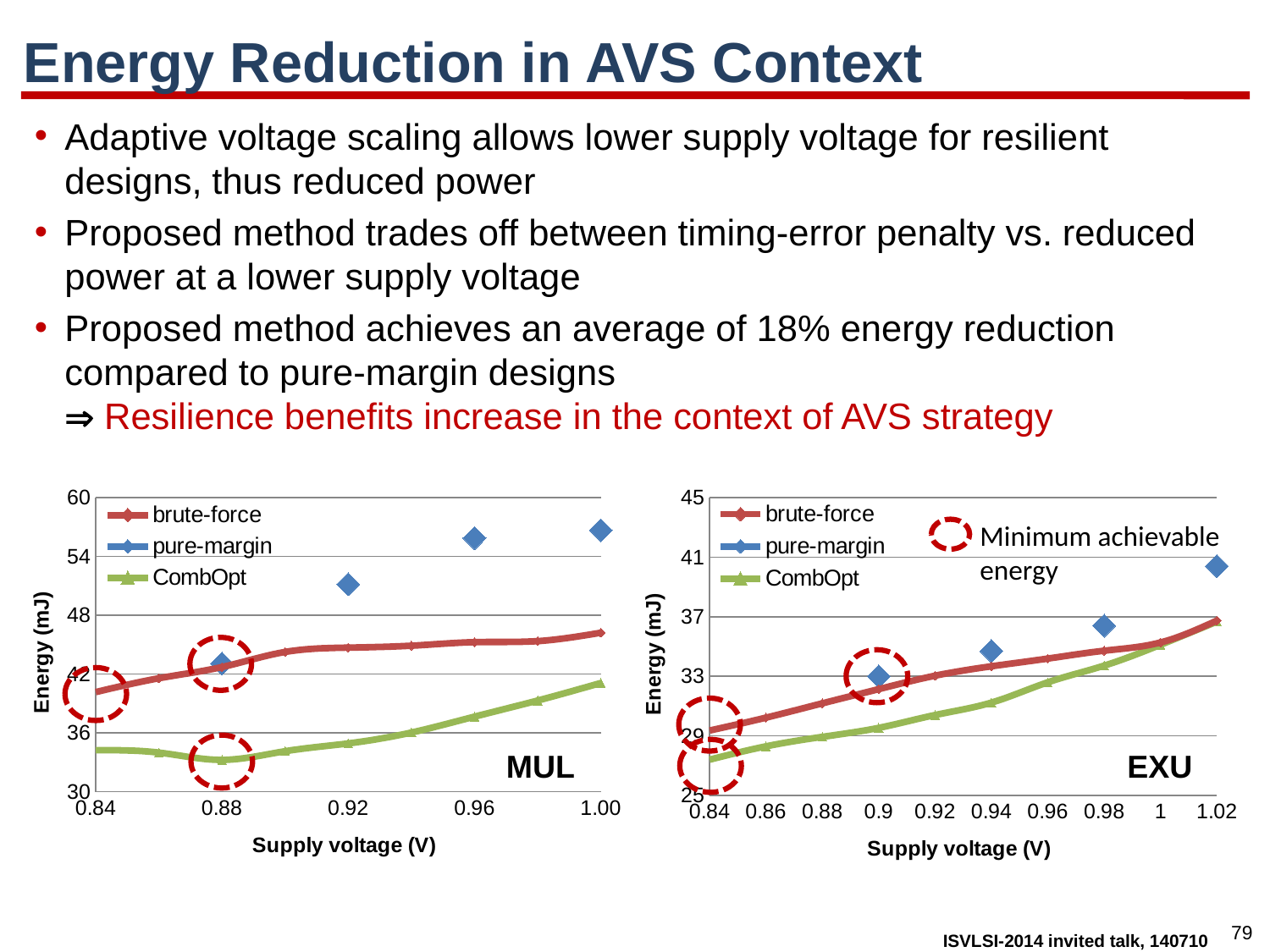
How many pure-margin data points are plotted in the MUL chart? 4 What is the y-axis title of the EXU chart? Energy (mJ) In the EXU chart, is the pure-margin value at 0.94 V greater or less than 33? greater In the MUL chart, at 1.00 V, which series has the higher energy: pure-margin or brute-force? pure-margin In the EXU chart, does the CombOpt energy rise or fall as supply voltage increases from 0.84 V to 1.02 V? rise In the EXU chart, is the CombOpt value at 0.84 V greater or less than 29? less How many series does the legend of the EXU chart list? 3 In the MUL chart, is the brute-force value at 1.00 V greater or less than 48? less What kind of chart is the MUL chart on the left? line chart In the MUL chart, at 0.88 V, which series has the higher energy: brute-force or CombOpt? brute-force